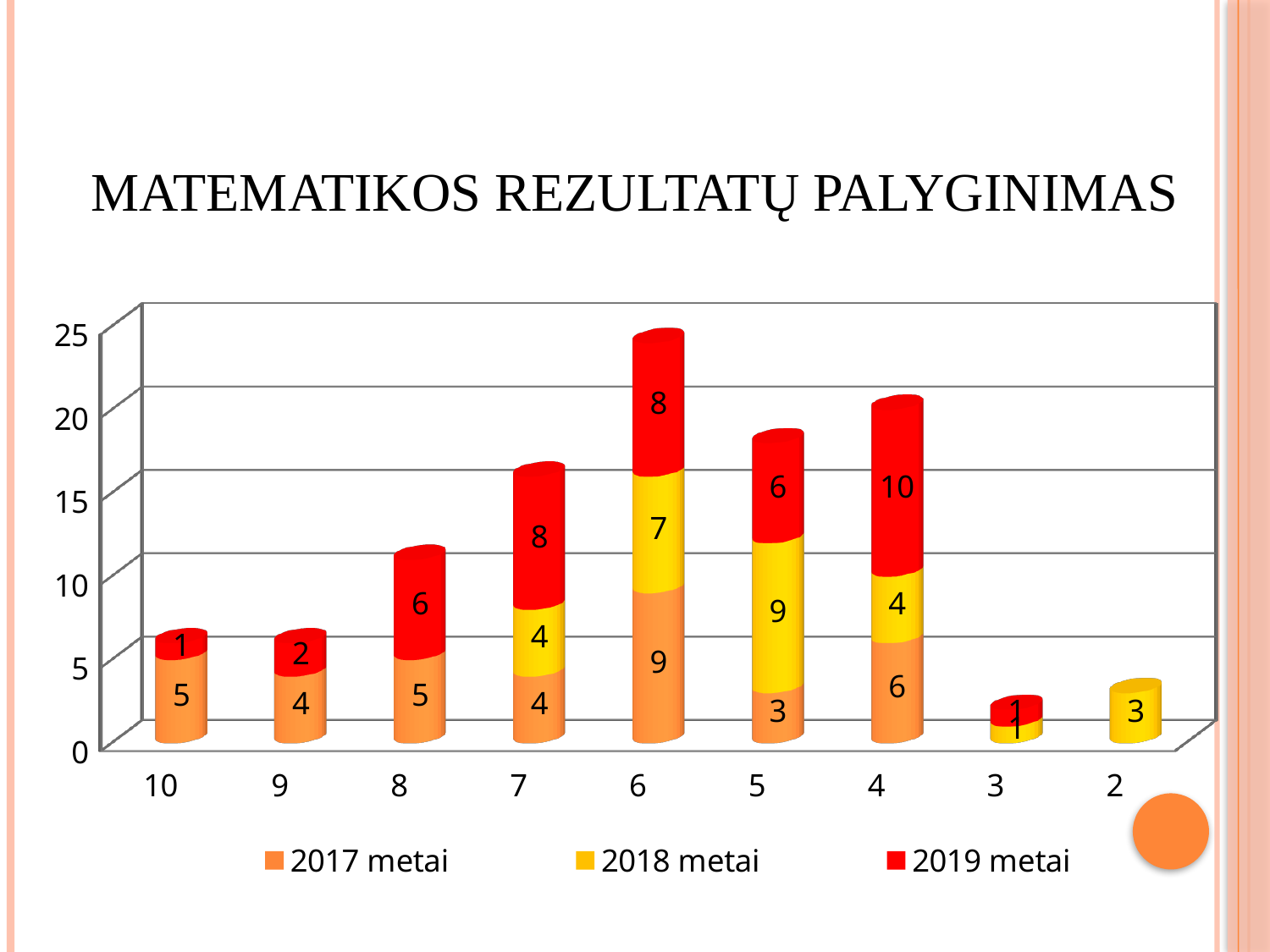
What is the value for 2018 metai at category 5? 9 Which category has the tallest stacked bar overall? 6 What is the title of the chart? MATEMATIKOS REZULTATŲ PALYGINIMAS How many categories are shown on the x axis? 9 What is the total of the stacked bar for category 7? 16 What is the value for 2019 metai at category 4? 10 What is the difference between the 2019 metai value and the 2017 metai value at category 5? 3 How many series does the legend list? 3 What type of chart is shown on the slide? stacked bar chart Which category has the highest value for 2019 metai? 4 Which is larger: the 2017 metai value at category 10 or the 2017 metai value at category 9? category 10 What is the value for 2017 metai at category 6? 9